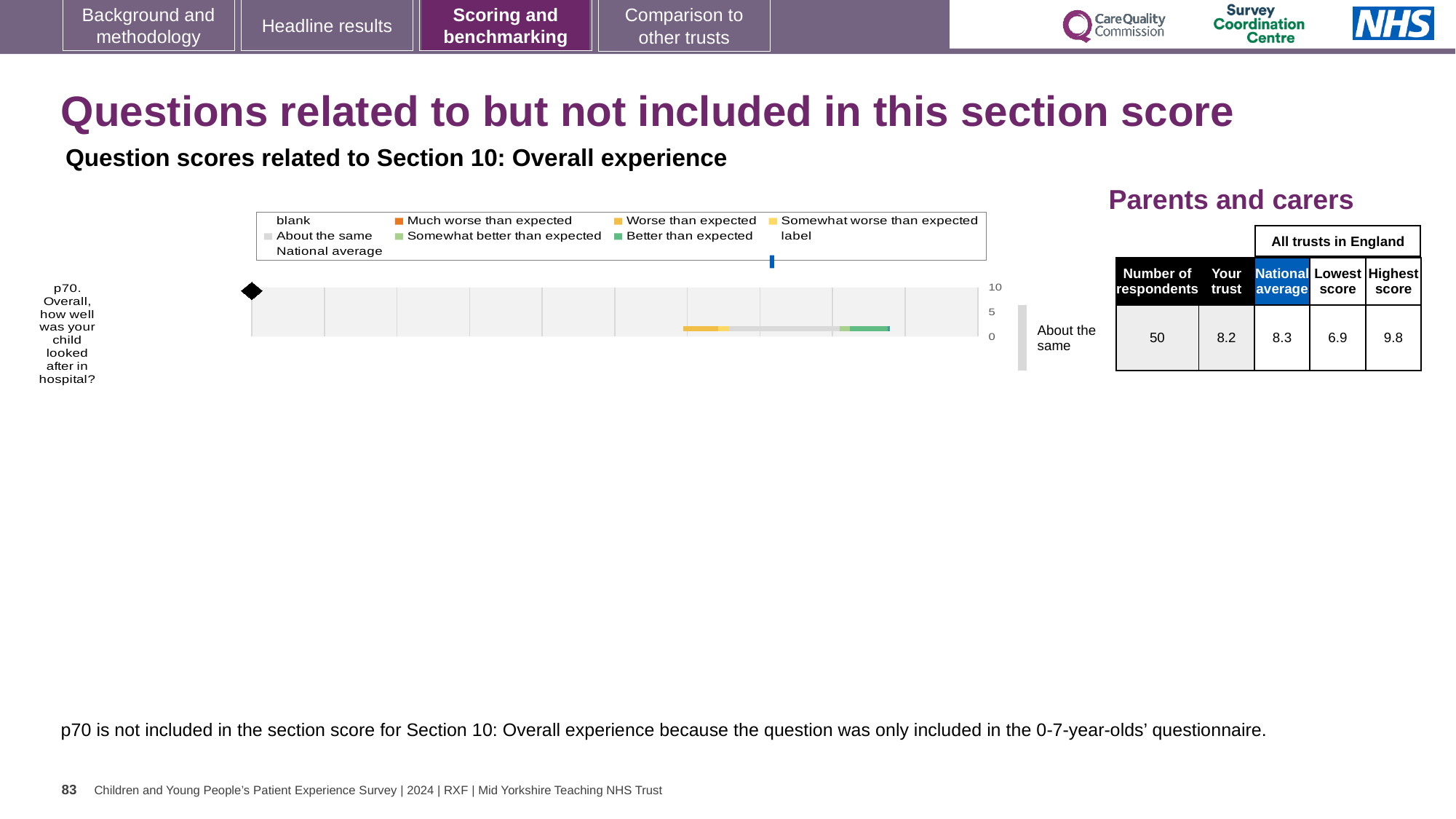
What is the 'Your trust' score for p70 (Overall, how well was your child looked after in hospital?)? 8.2 What is the national average score for p70? 8.3 What is the difference between the highest and lowest trust scores for p70? 2.9 Which is larger for p70, the trust's score or the national average? National average How many respondents answered question p70? 50 What is the lowest score among all trusts in England for p70? 6.9 How many questions are plotted in the chart? 1 What benchmark category label is shown next to the p70 bar? About the same What kind of chart is used to show the p70 question score? bar chart What is the highest score among all trusts in England for p70? 9.8 By how much does the national average exceed the trust's score for p70? 0.1 Is the trust's score for p70 greater or less than 5? greater